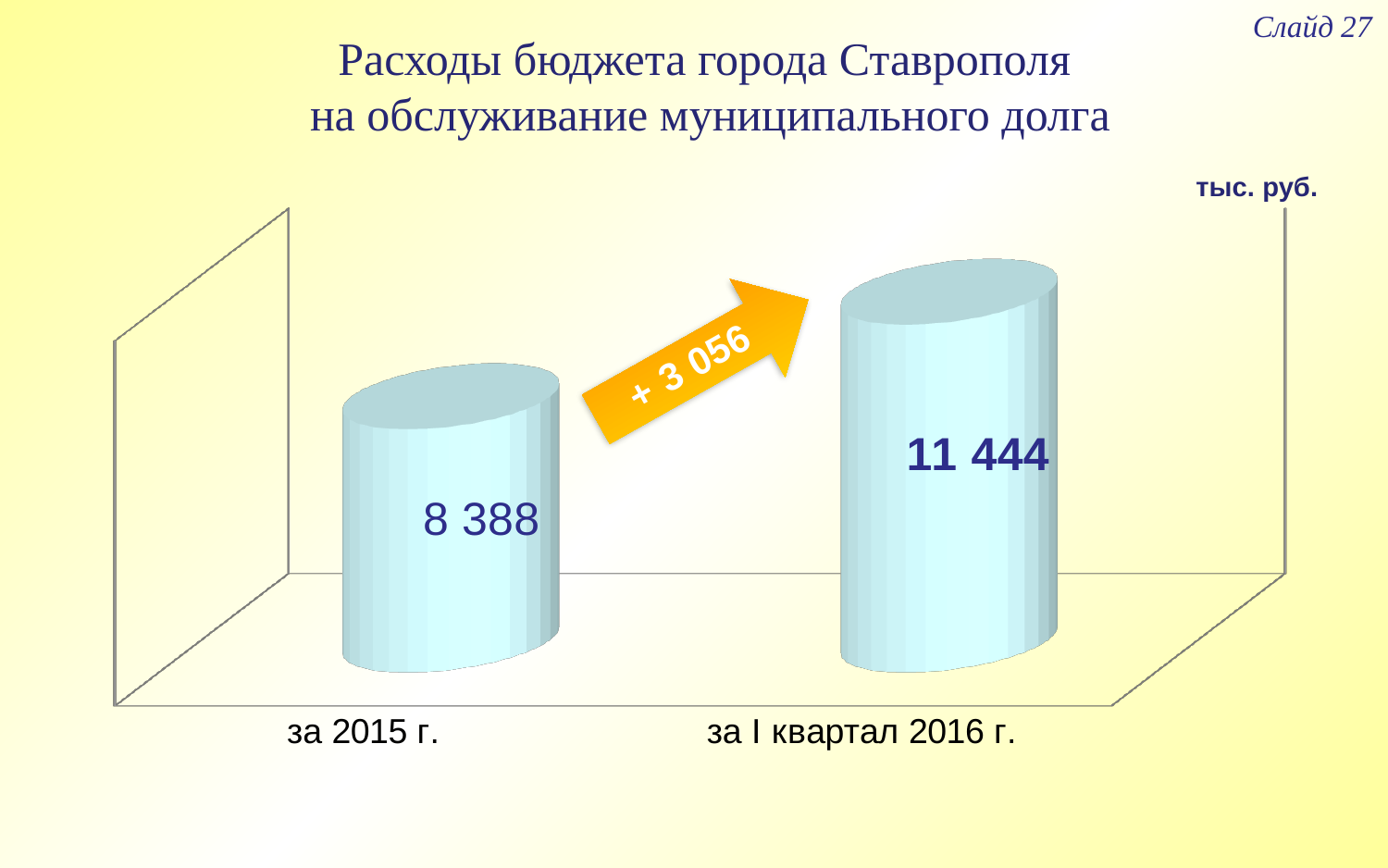
What change is written on the arrow between the two bars? + 3 056 Which is larger: the value for "за 2015 г." or the value for "за I квартал 2016 г."? за I квартал 2016 г. What is the title of the chart? Расходы бюджета города Ставрополя на обслуживание муниципального долга What is the difference between the value for "за I квартал 2016 г." and the value for "за 2015 г."? 3 056 Which category has the highest value? за I квартал 2016 г. What is the value for "за I квартал 2016 г."? 11 444 What kind of chart is shown on the slide? bar chart What is the value for "за 2015 г."? 8 388 Do the values rise or fall from "за 2015 г." to "за I квартал 2016 г."? rise What unit is indicated for the values on the chart? тыс. руб. How many categories are shown on the chart? 2 Which category has the lowest value? за 2015 г.